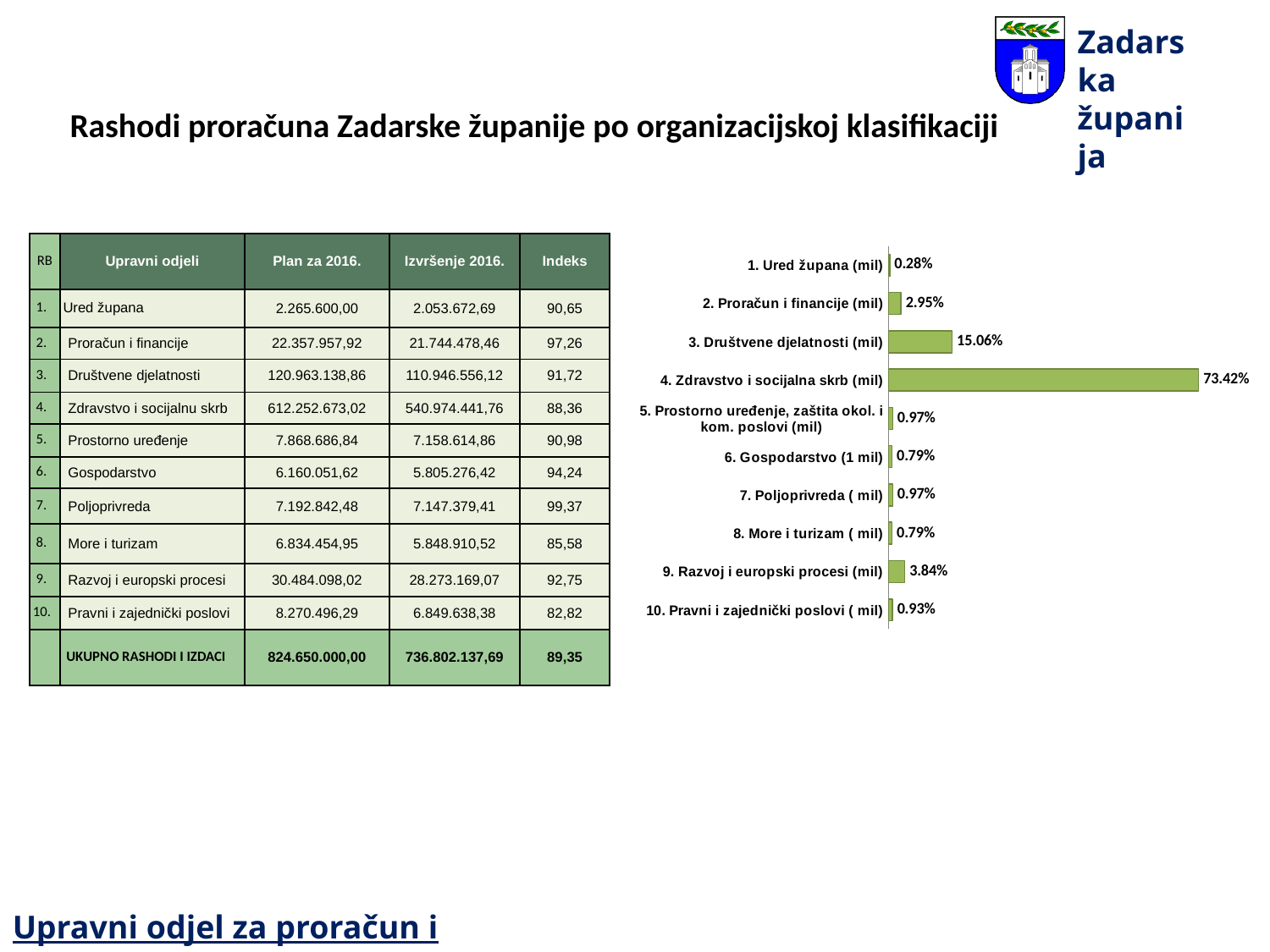
What is the value shown for "4. Zdravstvo i socijalna skrb (mil)" in the bar chart? 73.42% What kind of chart is shown on the slide? bar chart What is the difference between the values for "4. Zdravstvo i socijalna skrb (mil)" and "3. Društvene djelatnosti (mil)" in the bar chart? 58.36% What is the value shown for "9. Razvoj i europski procesi (mil)" in the bar chart? 3.84% Which category has the lowest value in the bar chart? 1. Ured župana (mil) How many categories does the bar chart show? 10 What is the value shown for "1. Ured župana (mil)" in the bar chart? 0.28% What is the value shown for "10. Pravni i zajednički poslovi ( mil)" in the bar chart? 0.93% Which is larger in the bar chart: the value for "2. Proračun i financije (mil)" or the value for "9. Razvoj i europski procesi (mil)"? 9. Razvoj i europski procesi (mil) What colour are the bars in the bar chart? green What is the value shown for "3. Društvene djelatnosti (mil)" in the bar chart? 15.06% Which category has the highest value in the bar chart? 4. Zdravstvo i socijalna skrb (mil)